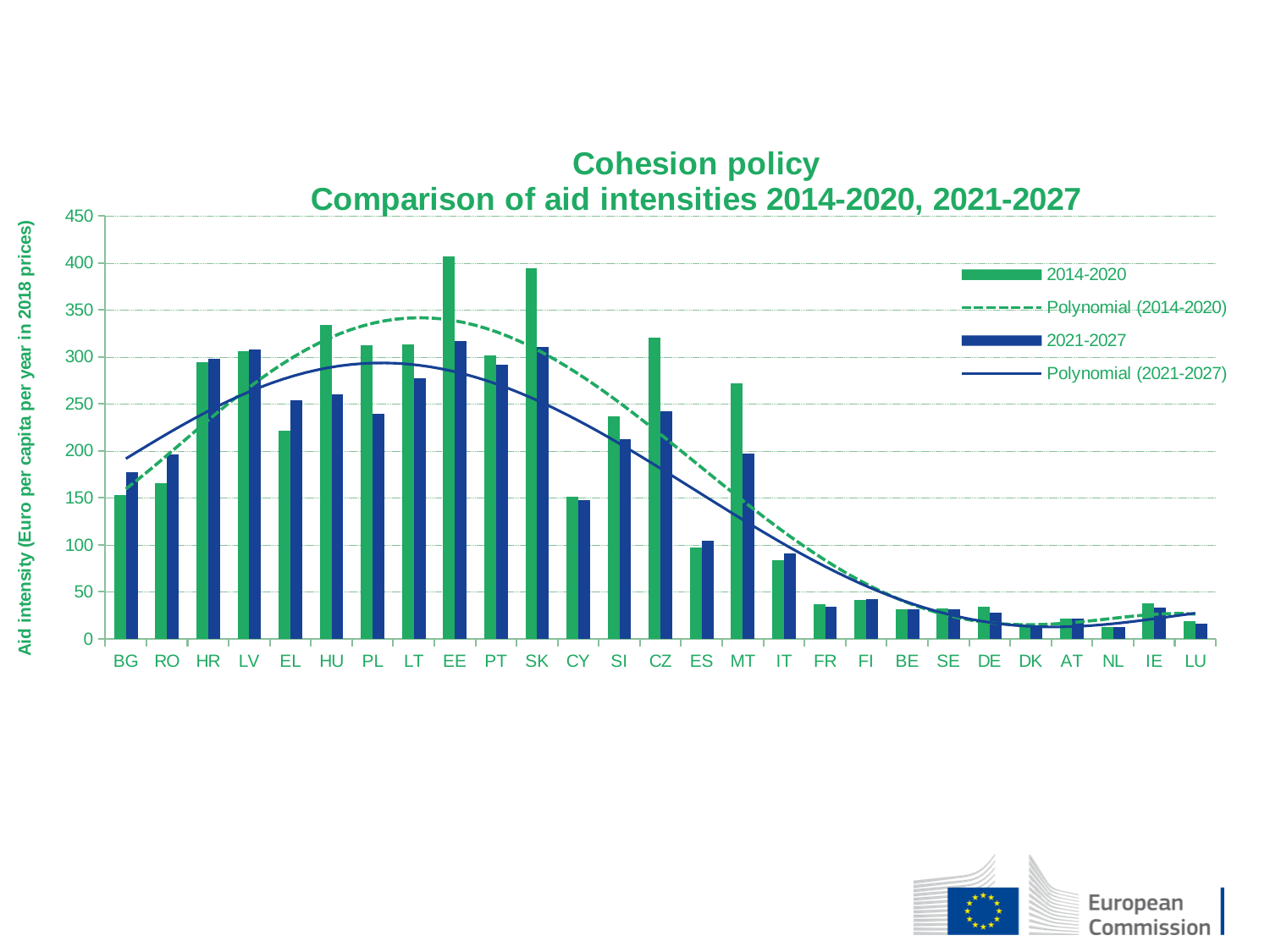
Do the aid intensity values generally rise or fall moving from BG on the left to LU on the right? fall What is the title of the vertical axis? Aid intensity (Euro per capita per year in 2018 prices) Is the 2014-2020 value for IT greater or less than 100? less Which country has the highest 2014-2020 aid intensity? EE For EL, which period has the larger aid intensity, 2014-2020 or 2021-2027? 2021-2027 Is the 2014-2020 value for EE greater or less than 400? greater What kind of chart is shown on the slide? bar chart Is the 2021-2027 value for PL greater or less than 250? less How many entries does the legend list? 4 For MT, which period has the larger aid intensity, 2014-2020 or 2021-2027? 2014-2020 How many countries are shown on the x axis? 27